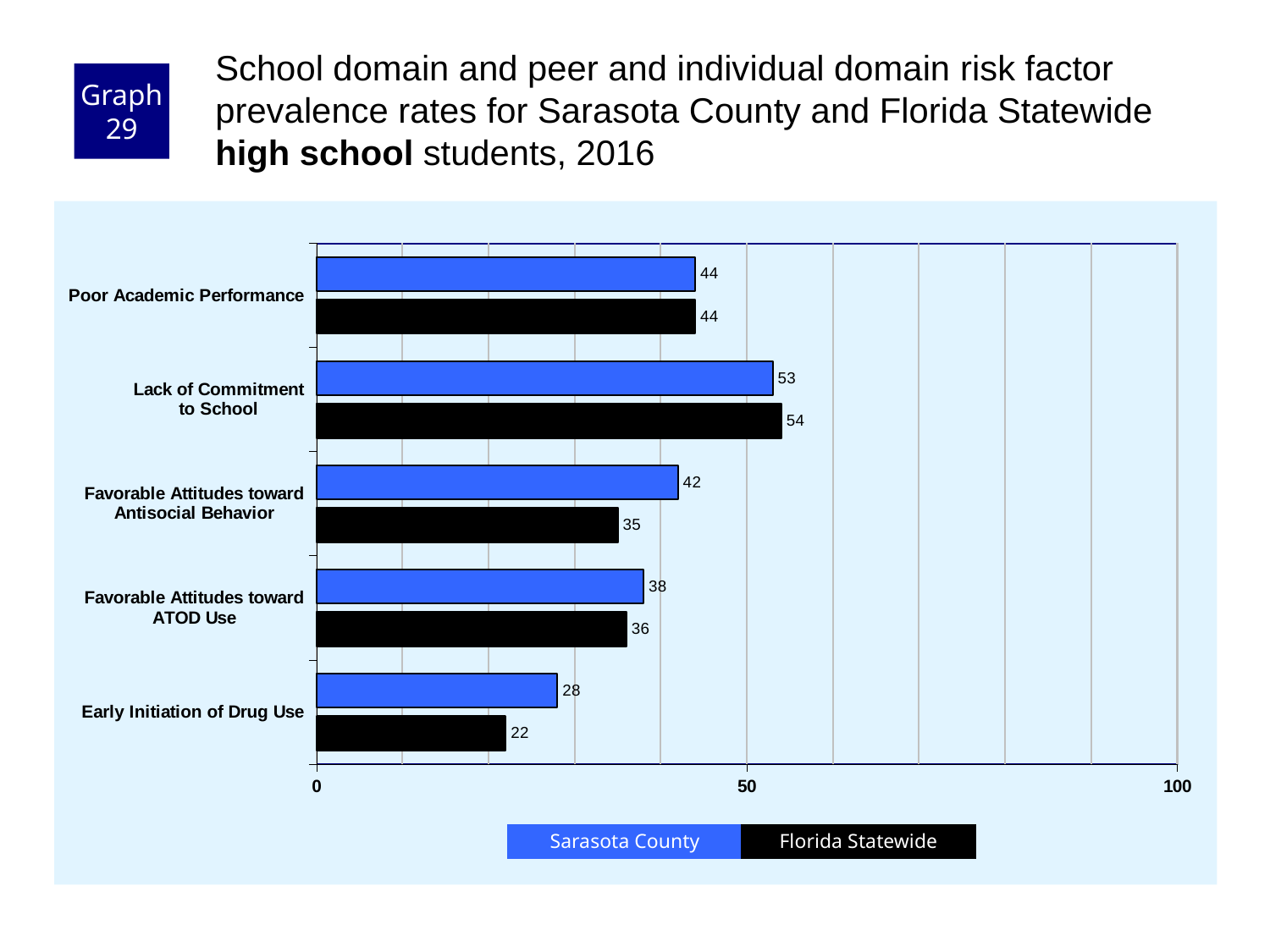
What is the Sarasota County value for Lack of Commitment to School? 53 For Favorable Attitudes toward ATOD Use, which is larger: the Sarasota County value or the Florida Statewide value? Sarasota County What kind of chart is shown on the slide? bar chart What is the difference between the Sarasota County and Florida Statewide values for Favorable Attitudes toward Antisocial Behavior? 7 What is the Florida Statewide value for Favorable Attitudes toward Antisocial Behavior? 35 How many risk factor categories are shown on the chart? 5 How many series does the legend list? 2 What is the Florida Statewide value for Early Initiation of Drug Use? 22 Which risk factor has the lowest Florida Statewide value? Early Initiation of Drug Use Is the Florida Statewide value for Lack of Commitment to School greater or less than 50? greater Which risk factor has the highest Sarasota County value? Lack of Commitment to School What is the difference between the Sarasota County and Florida Statewide values for Early Initiation of Drug Use? 6